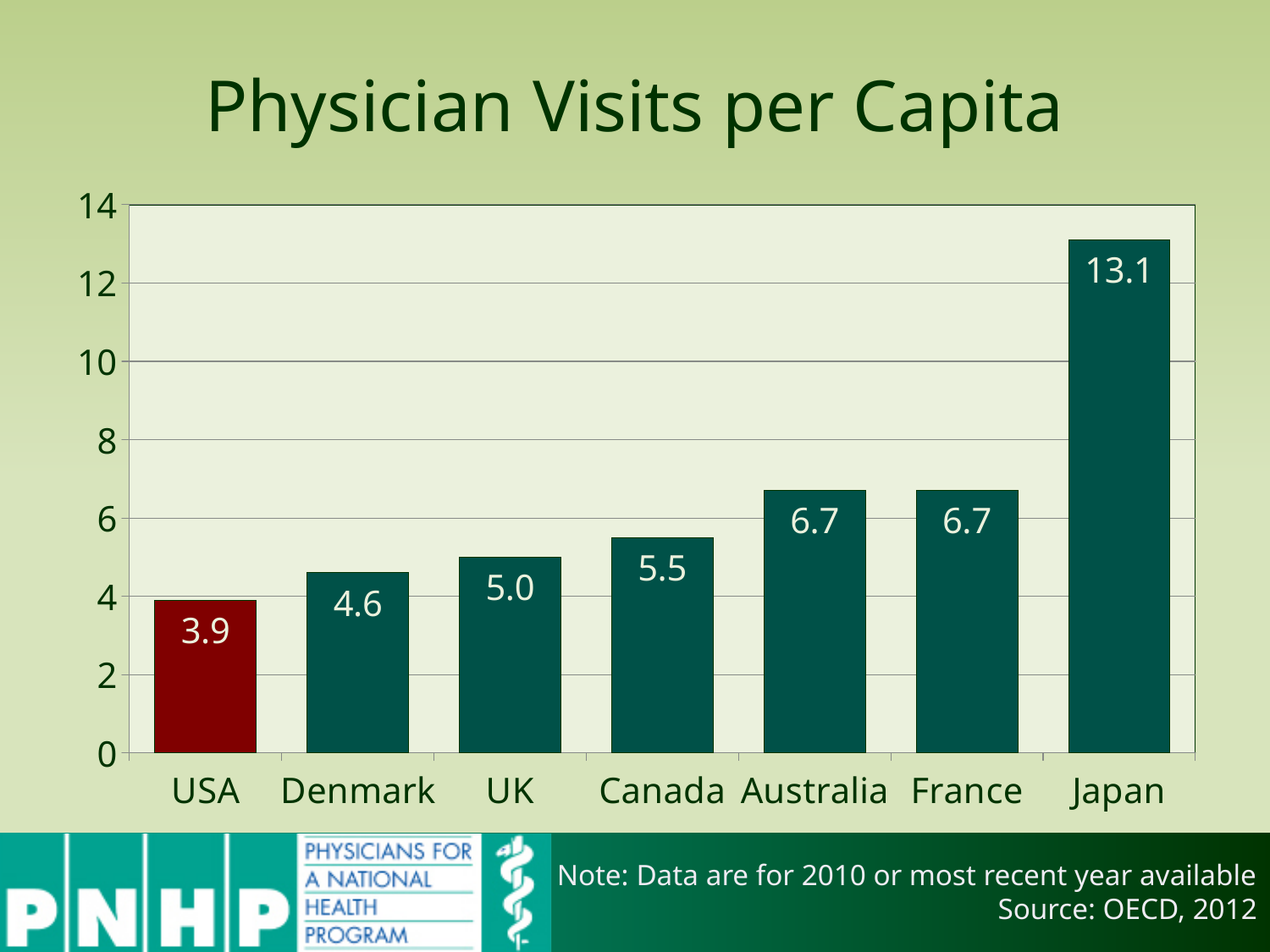
How many countries are shown on the chart? 7 Which country has the highest physician visits per capita? Japan What kind of chart is shown on the slide? bar chart What is the difference between the values for Japan and the USA? 9.2 Which is larger, the value for the UK or the value for Australia? Australia What is the title of the chart? Physician Visits per Capita What is the value for Japan? 13.1 What is the difference between the values for Canada and Denmark? 0.9 Which country has the lowest physician visits per capita? USA What is the value for the USA? 3.9 What is the value for Canada? 5.5 Is the value for Japan greater or less than 12? greater